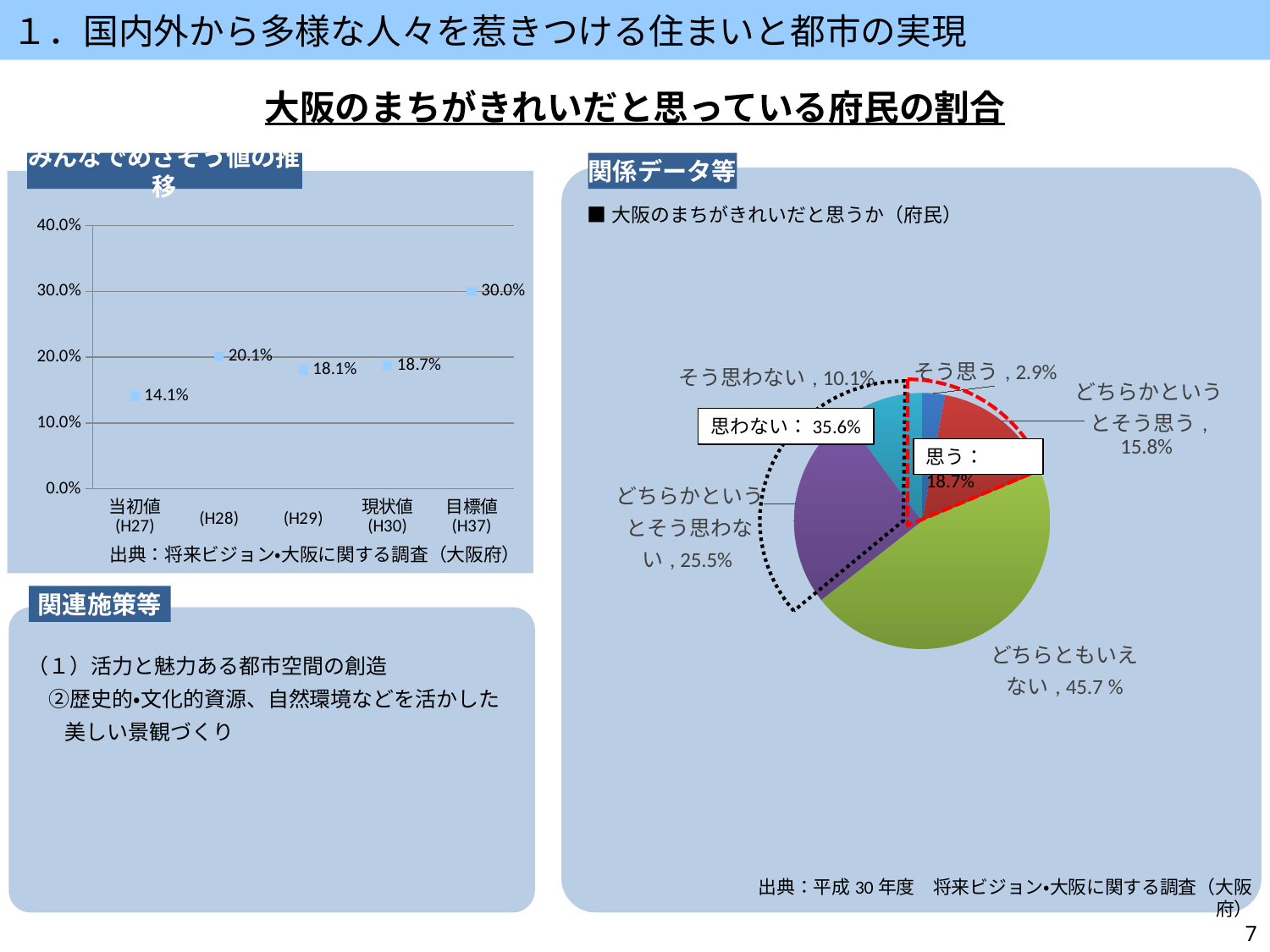
In the left chart (みんなでめざそう値の推移), what is the value for 当初値 (H27)? 14.1% In the left chart (みんなでめざそう値の推移), which is larger, the value for (H28) or the value for (H29)? (H28) In the left chart (みんなでめざそう値の推移), what is the value for 目標値 (H37)? 30.0% In the pie chart on the right (大阪のまちがきれいだと思うか), what is the share for どちらともいえない? 45.7% What kind of chart is shown on the right side of the slide? Pie chart In the left chart (みんなでめざそう値の推移), which category has the lowest value? 当初値 (H27) In the pie chart on the right (大阪のまちがきれいだと思うか), how many slices does the pie have? 5 In the left chart (みんなでめざそう値の推移), what is the difference between the 目標値 (H37) value and the 現状値 (H30) value? 11.3% In the pie chart on the right (大阪のまちがきれいだと思うか), which slice is the smallest? そう思う In the left chart (みんなでめざそう値の推移), what is the value for 現状値 (H30)? 18.7% In the pie chart on the right (大阪のまちがきれいだと思うか), what is the share for どちらかというとそう思わない? 25.5% In the left chart (みんなでめざそう値の推移), how many data points are plotted? 5